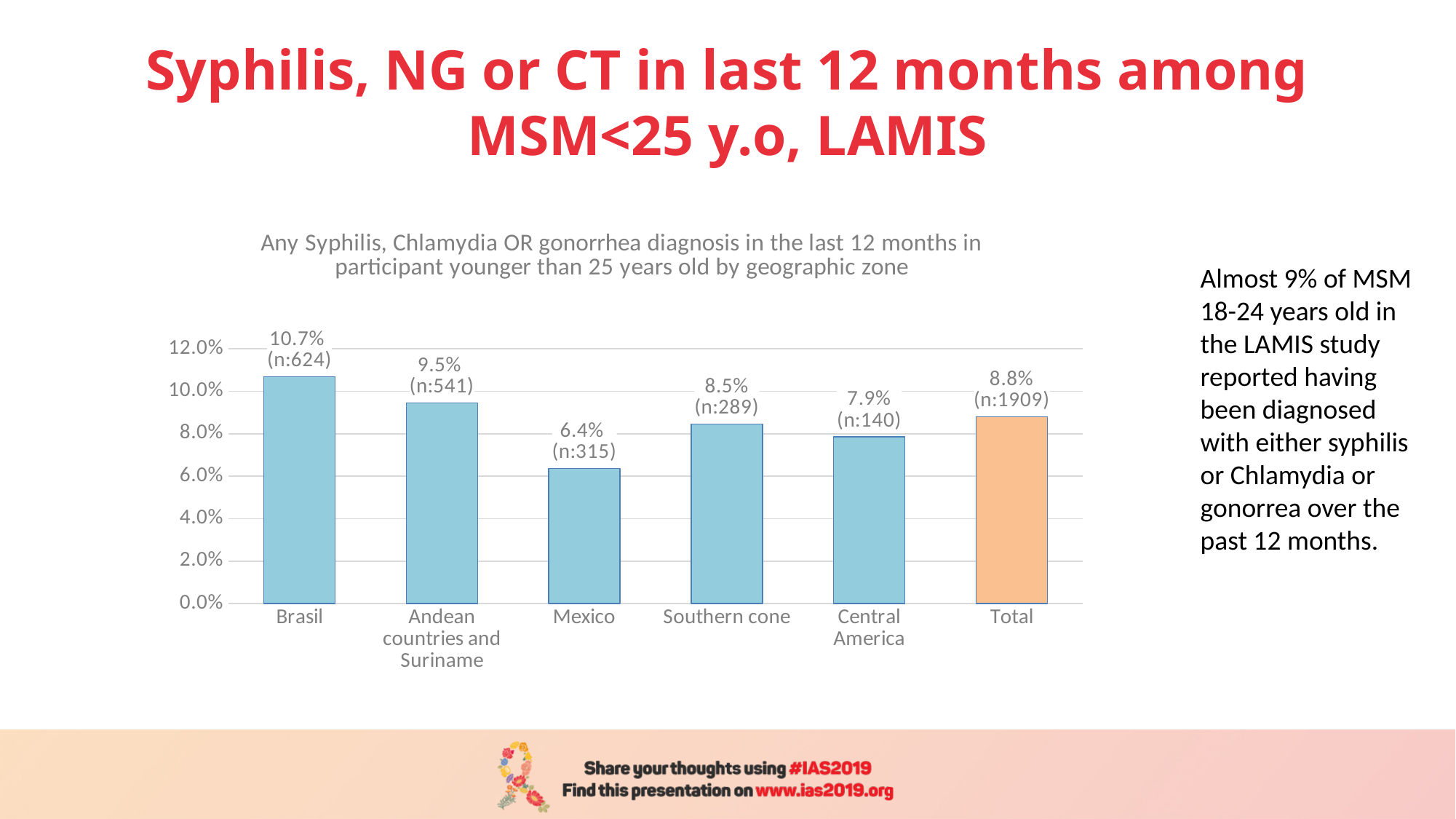
Which geographic zone has the lowest value? Mexico Which is larger, the value for Southern cone or the value for Central America? Southern cone How many bars are shown in the chart? 6 What kind of chart is shown on the slide? Bar chart What is the sample size (n) shown for the Total bar? 1909 What is the value for Brasil? 10.7% What is the difference between the values for Brasil and Mexico? 4.3% Is the value for Andean countries and Suriname greater or less than 8.0%? greater What is the value for Central America? 7.9% Which geographic zone has the highest value? Brasil What is the value for Mexico? 6.4% Which bar is shown in a different colour (orange) from the others? Total